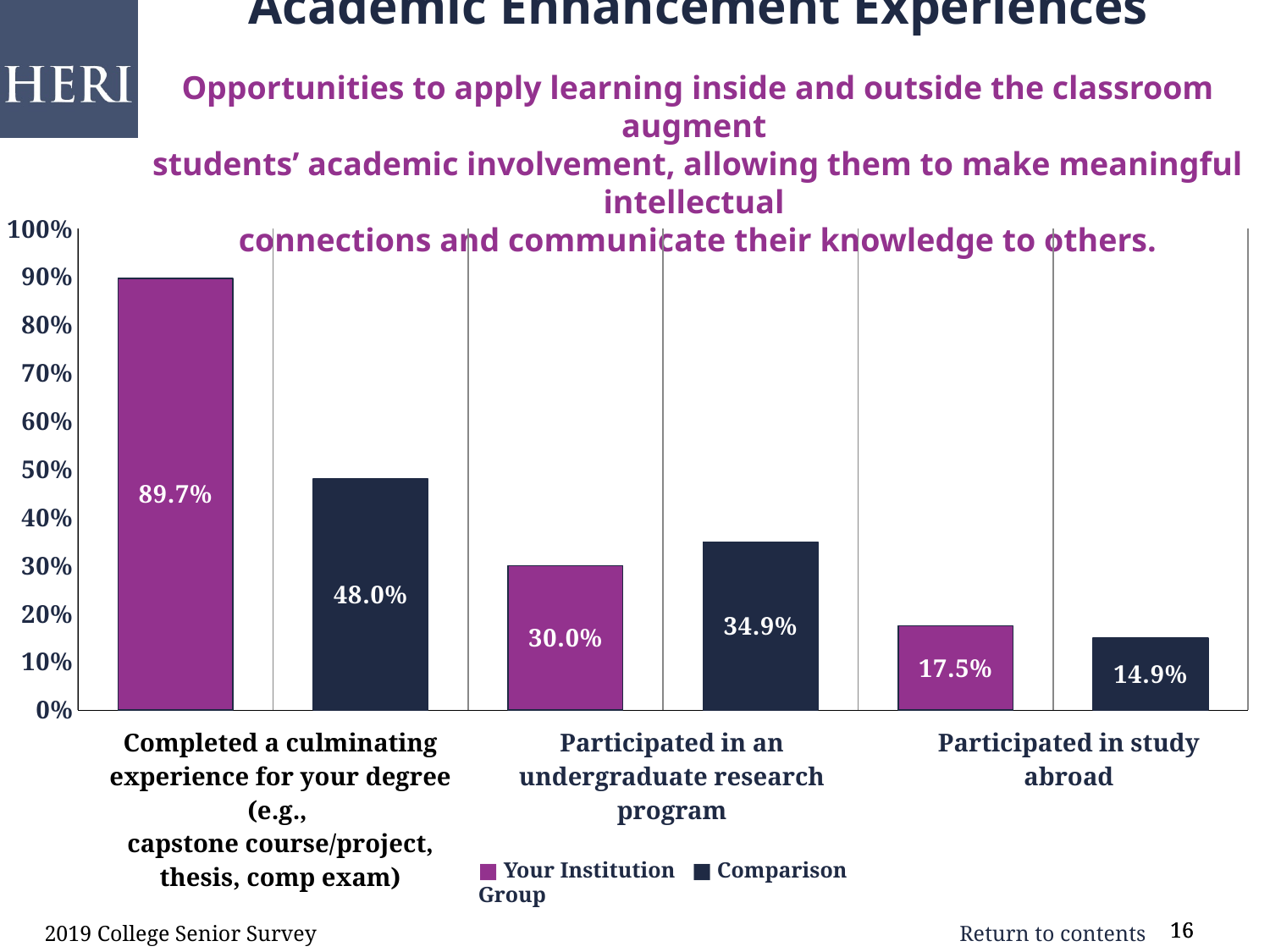
Which series is shown in purple in the legend? Your Institution Which category has the lowest value for Comparison Group? Participated in study abroad How many categories are shown on the x axis? 3 What is the difference between Your Institution and Comparison Group for 'Completed a culminating experience for your degree'? 41.7% Is the value for Comparison Group for 'Completed a culminating experience for your degree' greater or less than 50%? less What kind of chart is shown on the slide? bar chart Which is larger for 'Participated in an undergraduate research program': Your Institution or Comparison Group? Comparison Group Which category has the highest value for Your Institution? Completed a culminating experience for your degree What is the value for Your Institution for 'Participated in study abroad'? 17.5% How many series does the legend list? 2 What is the value for Your Institution for 'Completed a culminating experience for your degree'? 89.7% What is the value for Comparison Group for 'Participated in an undergraduate research program'? 34.9%